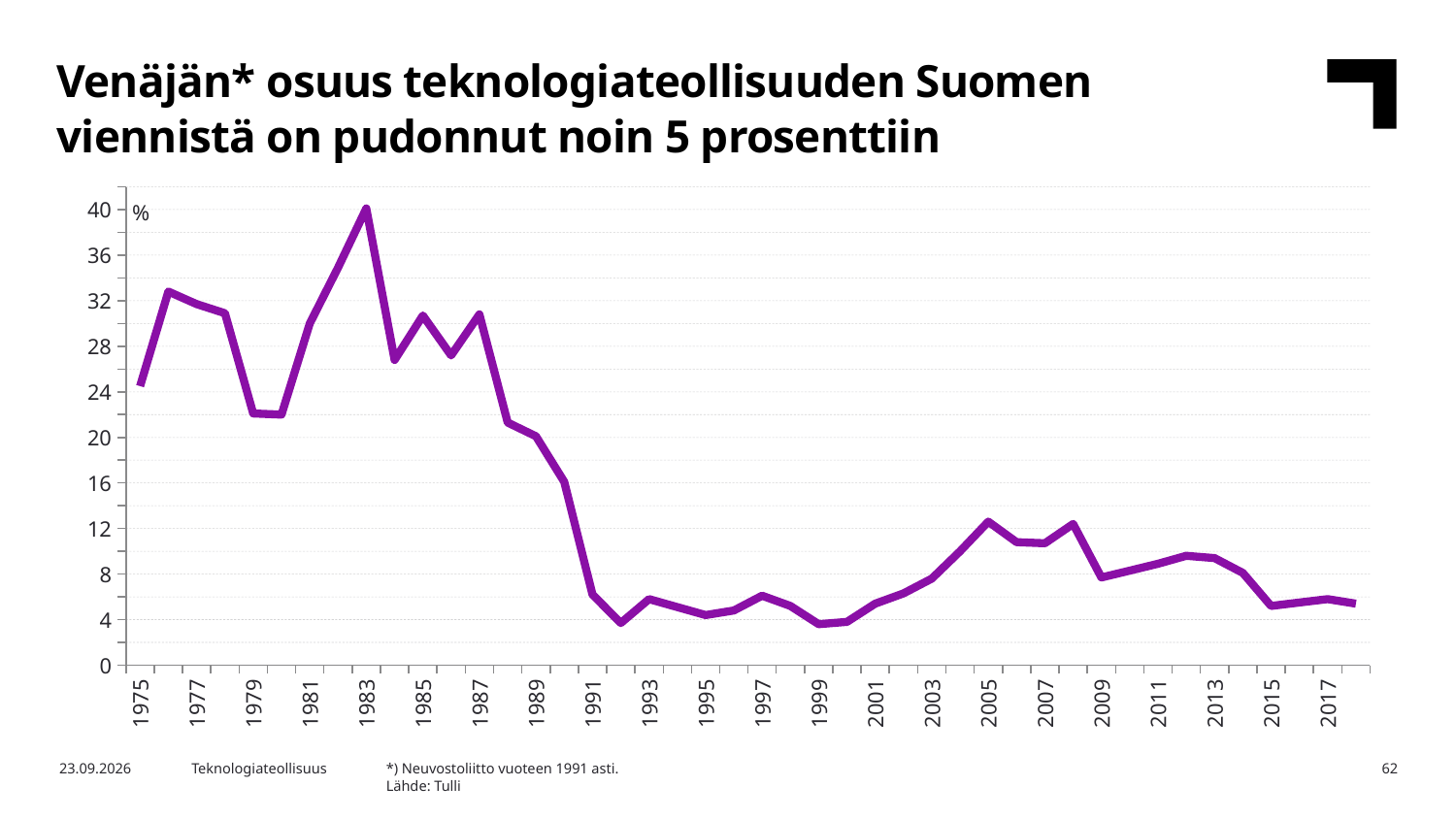
Is the value for 2015 greater or less than 8? less Which year has the larger value, 1989 or 1991? 1989 What kind of chart is shown on the slide? line chart Is the value for 1991 greater or less than 8? less Is the value for 1983 greater or less than 36? greater In which year does the line reach its highest value? 1983 What unit is shown on the vertical axis? % Which year has the larger value, 1983 or 1985? 1983 Overall, does the line rise or fall from 1975 to the end of the series? fall Which year has the larger value, 2005 or 2015? 2005